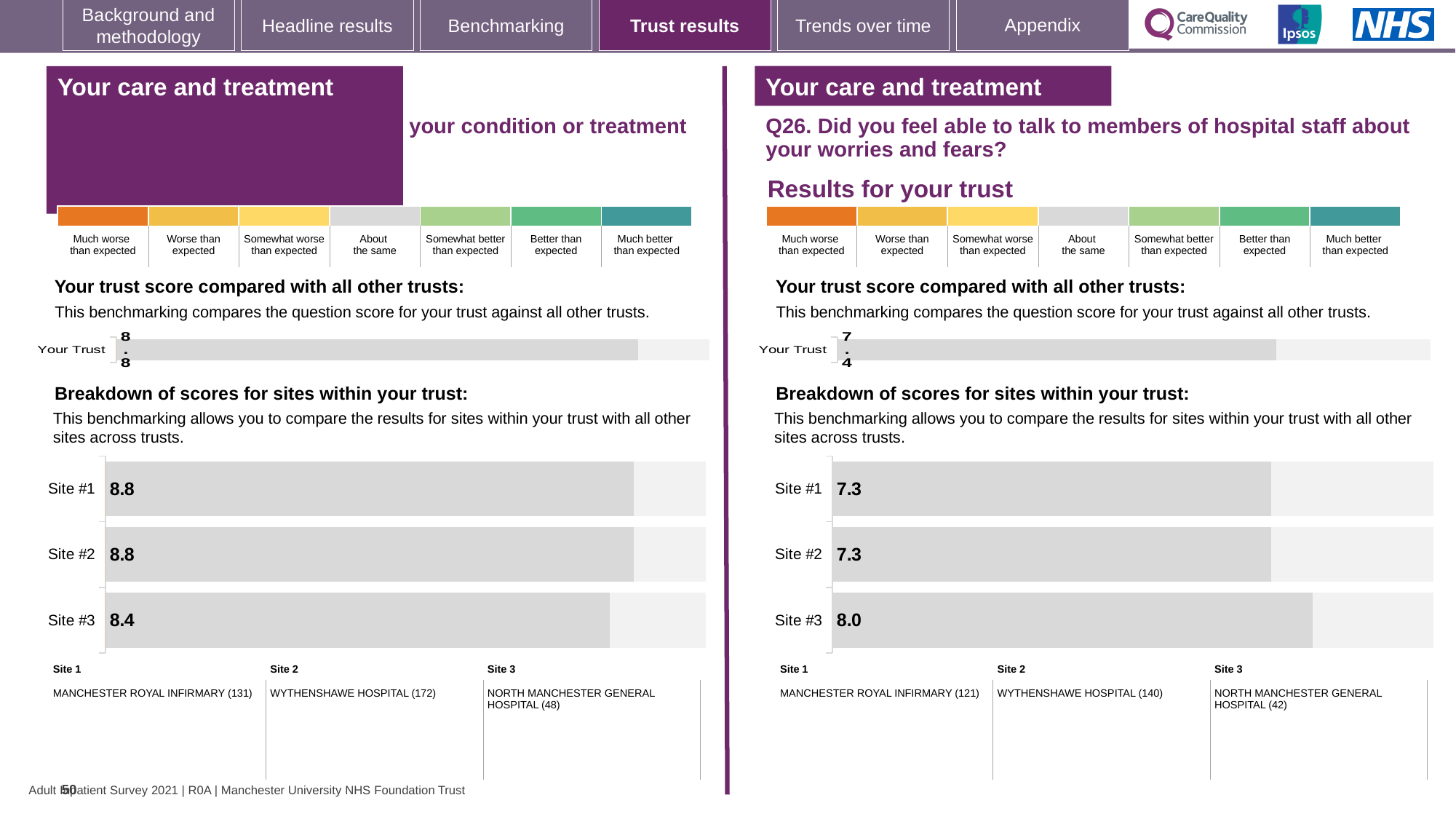
What type of chart is used for the site breakdown on the right-hand side of the slide? Bar chart On the left-hand site breakdown chart, which site has the lowest score? Site #3 On the right-hand chart for Q26, what is the score for Site #1? 7.3 On the left-hand site breakdown chart, what is the score for Site #2? 8.8 On the right-hand chart for Q26, what is the score for Site #3? 8.0 On the right-hand 'Your Trust' bar for Q26, what is the trust score shown? 7.4 On the left-hand site breakdown chart, what is the score for Site #3? 8.4 On the right-hand chart for Q26, which site has the highest score? Site #3 On the left-hand site breakdown chart, what is the difference between the Site #1 score and the Site #3 score? 0.4 On the right-hand chart for Q26, what is the difference between the Site #3 score and the Site #1 score? 0.7 How many sites are shown in the right-hand site breakdown chart for Q26? 3 On the left-hand 'Your Trust' bar, what is the trust score shown? 8.8